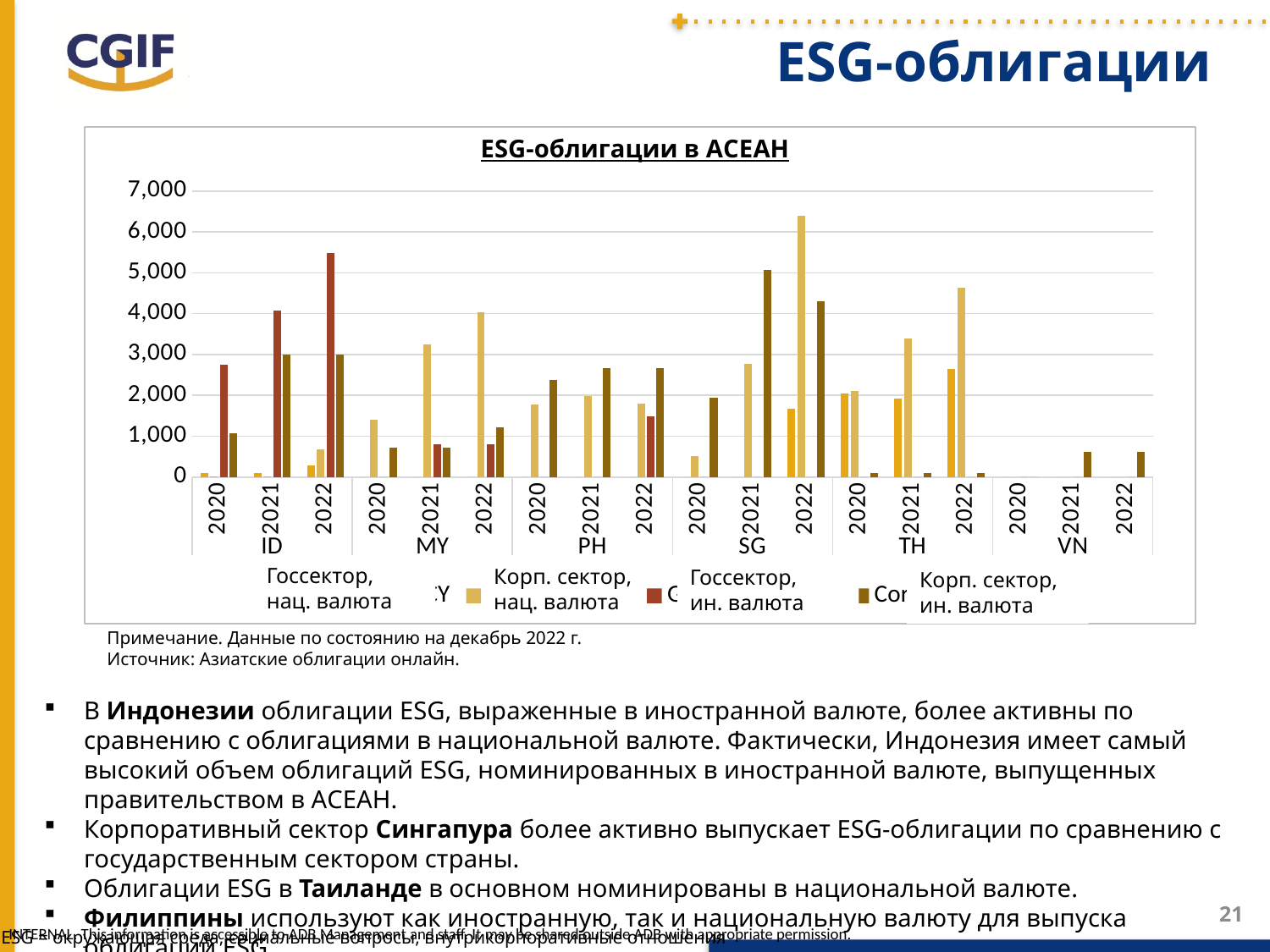
Which country and year has the tallest bar in the chart? SG, 2022 Is the value for Корп. сектор, нац. валюта in MY in 2021 greater or less than 3,000? greater Is the value for Корп. сектор, нац. валюта in SG in 2022 greater or less than 6,000? greater Which is larger: Госсектор, ин. валюта in ID in 2022 or Корп. сектор, нац. валюта in TH in 2022? Госсектор, ин. валюта in ID in 2022 What is the title of the chart? ESG-облигации в АСЕАН According to the note under the chart, as of which date are the data given? декабрь 2022 г. How many series does the legend of the chart list? 4 How many countries are shown along the x axis of the chart? 6 What kind of chart is shown on the slide? bar chart Is the value for Госсектор, ин. валюта in ID in 2022 greater or less than 5,000? greater Does the value for Корп. сектор, нац. валюта in TH rise or fall from 2020 to 2022? rise